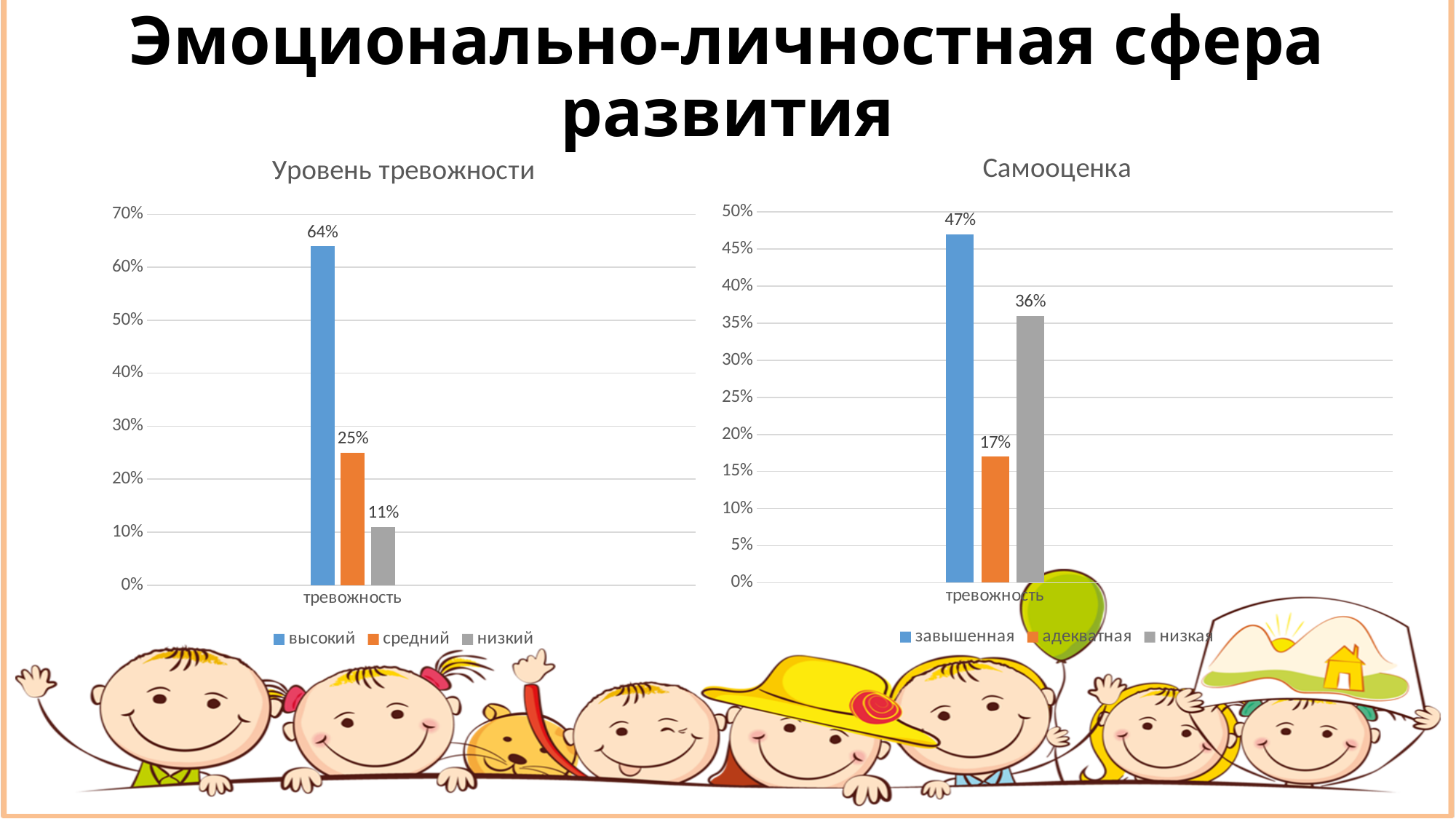
In the 'Самооценка' chart, what is the difference between 'завышенная' and 'низкая'? 11% In the 'Самооценка' chart, which series has the highest value? завышенная In the 'Самооценка' chart, what is the value for 'адекватная'? 17% In the 'Самооценка' chart, which is larger: 'низкая' or 'адекватная'? низкая In the 'Уровень тревожности' chart, what is the difference between 'высокий' and 'средний'? 39% In the 'Уровень тревожности' chart, how many series does the legend list? 3 In the 'Уровень тревожности' chart, which series has the lowest value? низкий In the 'Самооценка' chart, what is the value for 'низкая'? 36% In the 'Уровень тревожности' chart, what is the value for 'средний'? 25% In the 'Уровень тревожности' chart, what is the value for 'высокий'? 64% In the 'Уровень тревожности' chart, what colour is the bar for 'средний'? orange What kind of chart is the 'Самооценка' chart? bar chart